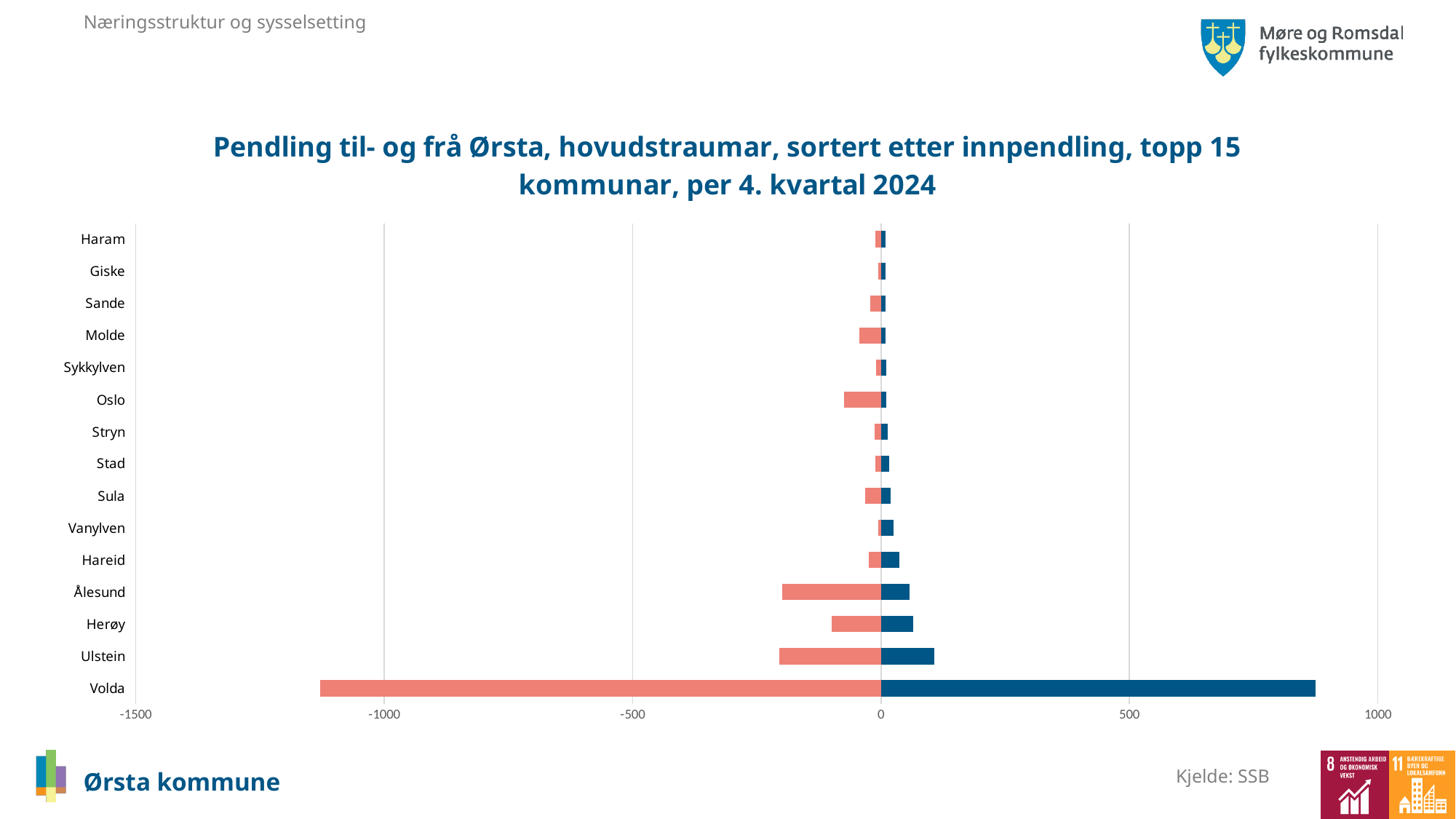
Is the value of the red bar for Volda greater or less than -1000? less Is the value of the blue bar for Volda greater or less than 1000? less Is the value of the red bar for Ålesund greater or less than -500? greater How many municipalities (categories) are listed on the vertical axis of the chart? 15 Which municipality has the longest red bar (utpendling) in the chart? Volda Which has the longer red bar, Ålesund or Herøy? Ålesund What is the title of the chart? Pendling til- og frå Ørsta, hovudstraumar, sortert etter innpendling, topp 15 kommunar, per 4. kvartal 2024 What kind of chart is shown on the slide? bar chart Which municipality has the longest blue bar (innpendling) in the chart? Volda What is the lowest value shown on the horizontal axis of the chart? -1500 Which has the longer blue bar, Ulstein or Herøy? Ulstein